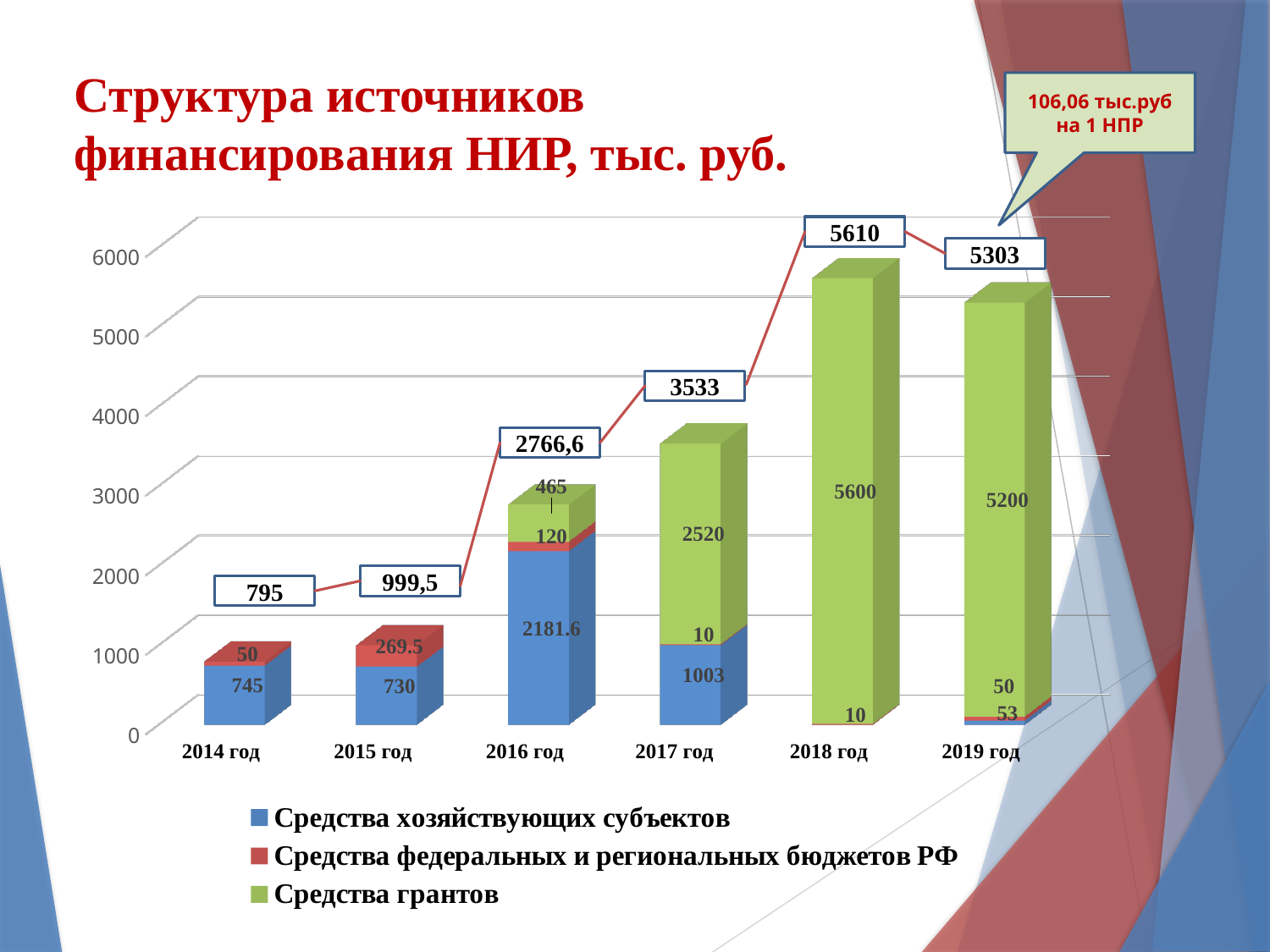
What is the value of Средства грантов for 2018 год? 5600 Which colour represents Средства грантов in the chart? Green How many years are shown on the x axis? 6 What kind of chart is shown on the slide? Stacked bar chart What is the value of Средства федеральных и региональных бюджетов РФ for 2015 год? 269.5 How many series does the legend list? 3 What is the difference between the Средства грантов values for 2018 год and 2019 год? 400 Which year has the highest total shown in the callouts? 2018 год Which is larger: Средства хозяйствующих субъектов in 2016 год or in 2017 год? 2016 год What total is shown in the callout for 2017 год? 3533 Which year has the lowest total shown in the callouts? 2014 год What is the value of Средства хозяйствующих субъектов for 2016 год? 2181.6